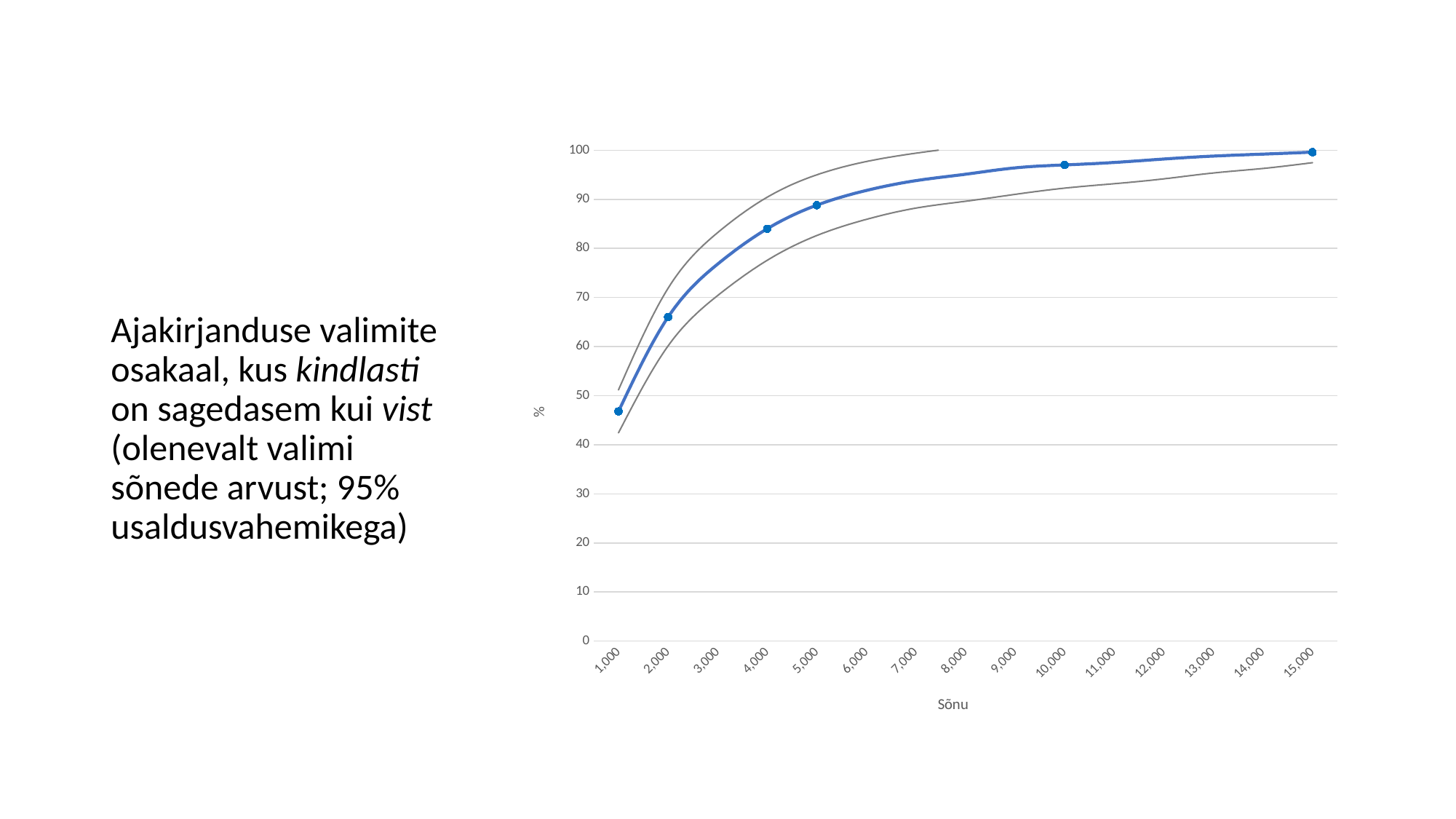
How many marked data points are on the blue line? 6 Is the value of the blue line at 4,000 words greater or less than 80? greater Is the value of the blue line at 10,000 words greater or less than 90? greater At which number of words does the blue line reach its highest value? 15,000 Is the value of the blue line at 1,000 words greater or less than 50? less What kind of chart is shown on the slide? line chart What is the label of the horizontal axis? Sõnu Which is larger on the blue line: the value at 2,000 words or the value at 5,000 words? 5,000 words At which number of words does the blue line have its lowest value? 1,000 Do the values on the blue line rise or fall as the number of words (Sõnu) increases? rise